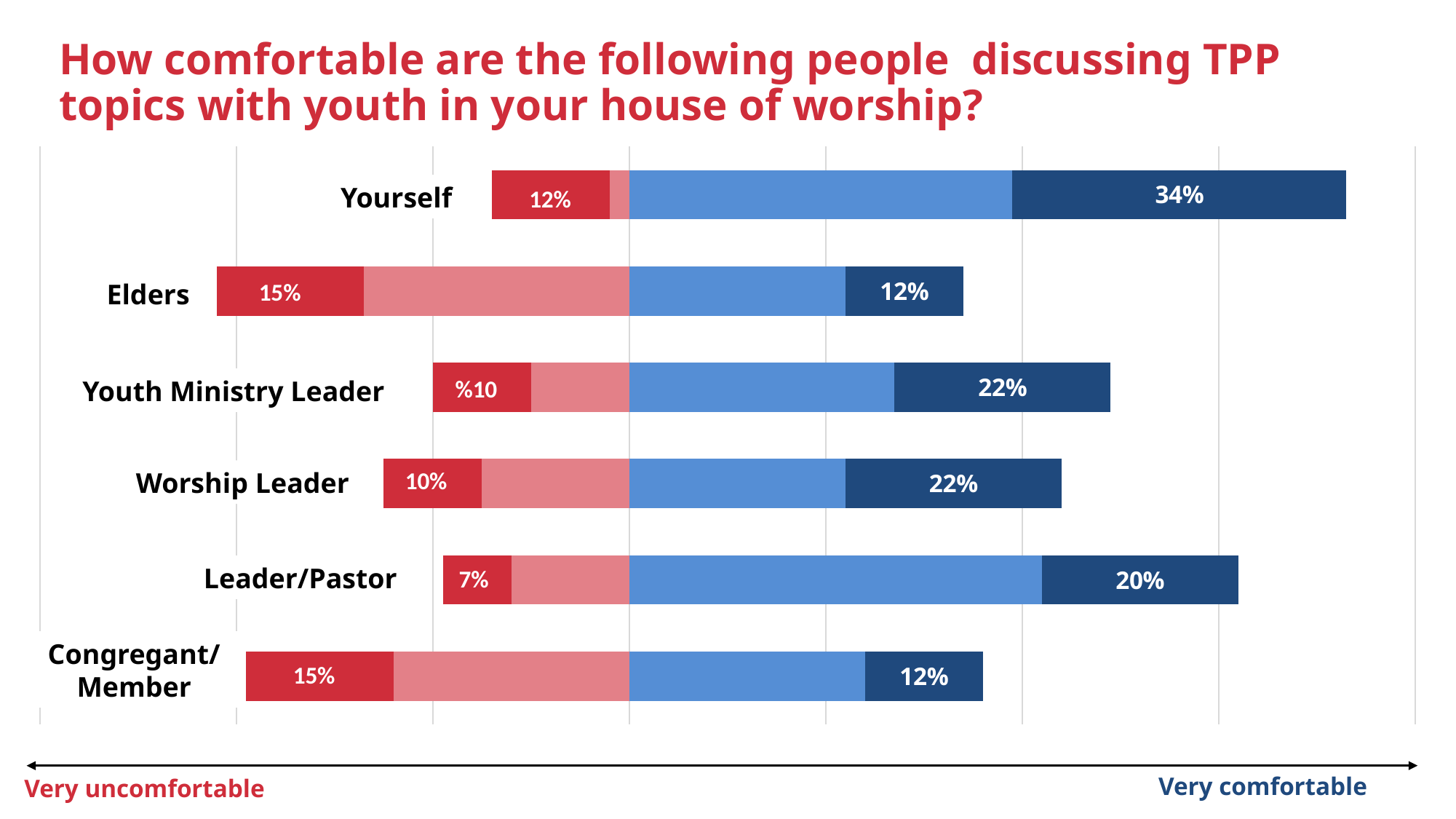
How many groups of people are shown in the chart? 6 Which has a larger very comfortable percentage: Yourself or Leader/Pastor? Yourself What is the very uncomfortable percentage shown for Worship Leader? 10% Which group has the lowest very uncomfortable percentage? Leader/Pastor What do the two ends of the horizontal scale below the chart represent? Very uncomfortable (left) and Very comfortable (right) What is the very comfortable percentage shown for Congregant/Member? 12% What percentage is shown for Elders being very uncomfortable discussing TPP topics with youth? 15% For "Yourself", how many percentage points higher is the very comfortable value than the very uncomfortable value? 22 percentage points What type of chart is shown on the slide? Bar chart What is the very comfortable percentage shown for Leader/Pastor? 20% Which group has the highest very comfortable percentage? Yourself What percentage of respondents said they themselves ("Yourself") are very comfortable discussing TPP topics with youth? 34%